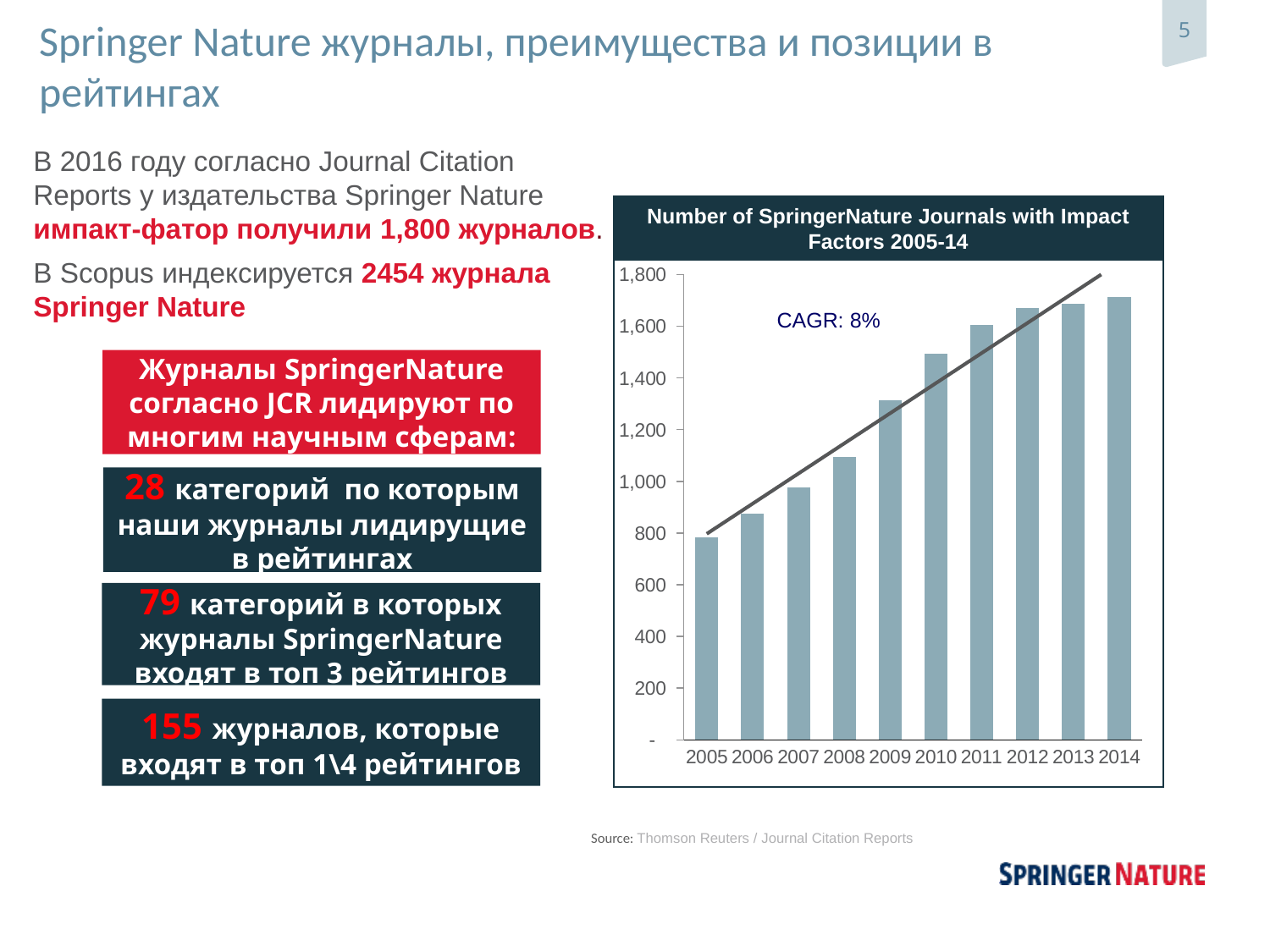
What kind of chart is shown on the slide? bar chart What is the title of the chart? Number of SpringerNature Journals with Impact Factors 2005-14 Is the value for 2010 greater or less than 1,400? greater How many years are shown on the x axis of the chart? 10 Is the value for 2014 greater or less than 1,600? greater Do the values rise or fall from 2005 to 2014? rise Is the value for 2005 greater or less than 1,000? less Which is larger, the value for 2009 or the value for 2012? 2012 Which year has the lowest number of SpringerNature journals with impact factors? 2005 What CAGR is annotated on the chart? 8%